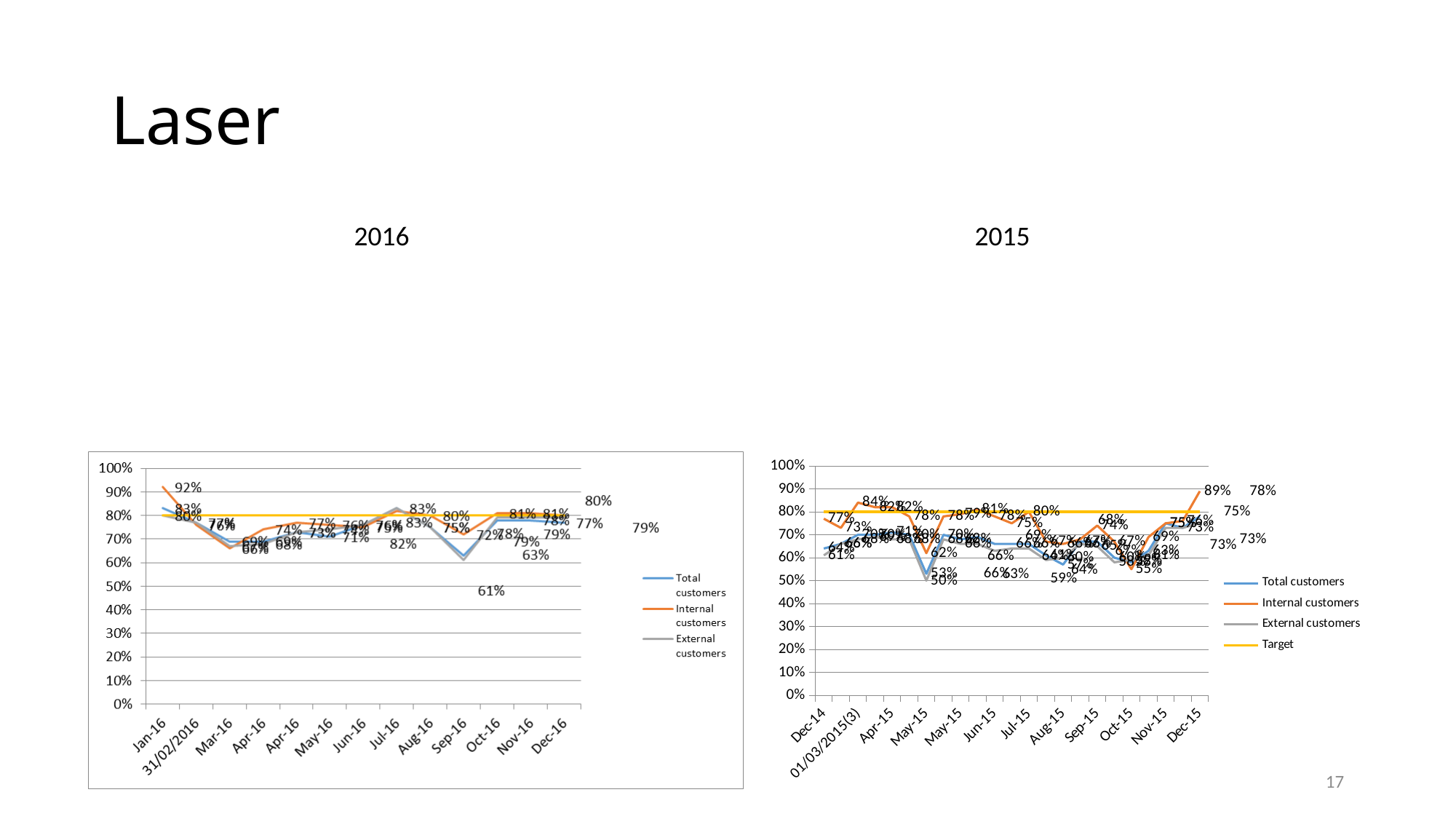
Which series is shown in yellow in the 2015 chart's legend? Target In the 2016 chart, is the value for Internal customers in Jan-16 greater or less than 90%? greater In the 2016 chart, what is the value for Internal customers in Jan-16? 92% How many categories are on the x axis of the 2015 chart? 12 In the 2015 chart, is the Target line above or below 70%? above How many series does the legend of the 2015 chart list? 4 What is the title of the slide containing the two charts? Laser In the 2015 chart, what is the value for Internal customers in Dec-15? 89% How many series does the legend of the 2016 chart list? 3 What kind of chart is the 2016 chart on the left? line chart In the 2016 chart, is the value for Total customers in Sep-16 greater or less than 70%? less